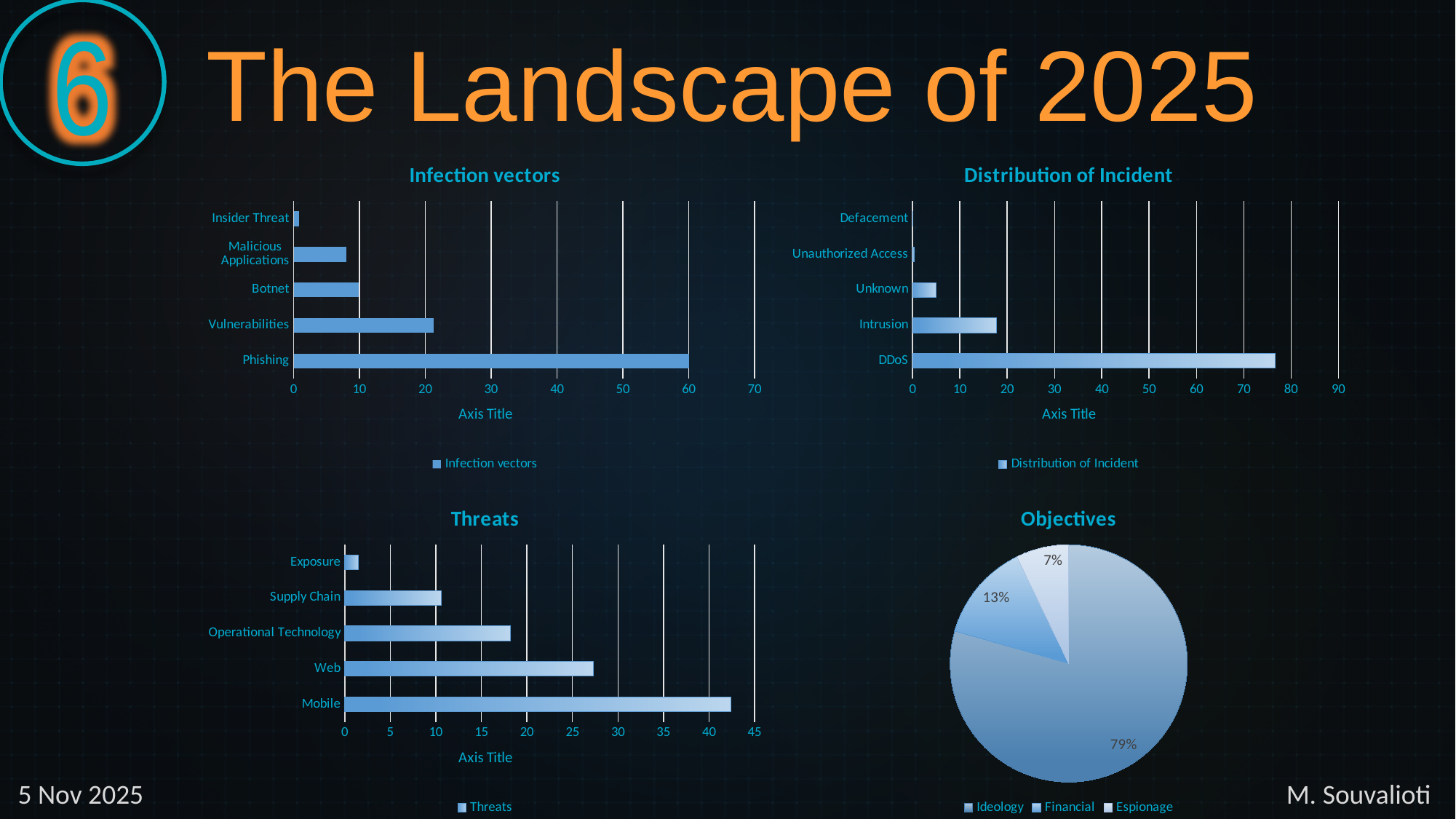
In the 'Infection vectors' chart, is the value for Vulnerabilities greater or less than 30? less In the 'Infection vectors' chart, which category has the highest value? Phishing What kind of chart is the 'Objectives' chart? pie chart In the 'Threats' chart, which category has the highest value? Mobile In the 'Distribution of Incident' chart, which is larger, Intrusion or Unknown? Intrusion In the 'Objectives' pie chart, what is the share of the largest slice? 79% How many categories are shown in the 'Infection vectors' chart? 5 In the 'Distribution of Incident' chart, which category has the highest value? DDoS In the 'Distribution of Incident' chart, is the value for DDoS greater or less than 70? greater In the 'Threats' chart, is the value for Web greater or less than 25? greater In the 'Infection vectors' chart, which category has the lowest value? Insider Threat What kind of chart is the 'Infection vectors' chart? bar chart